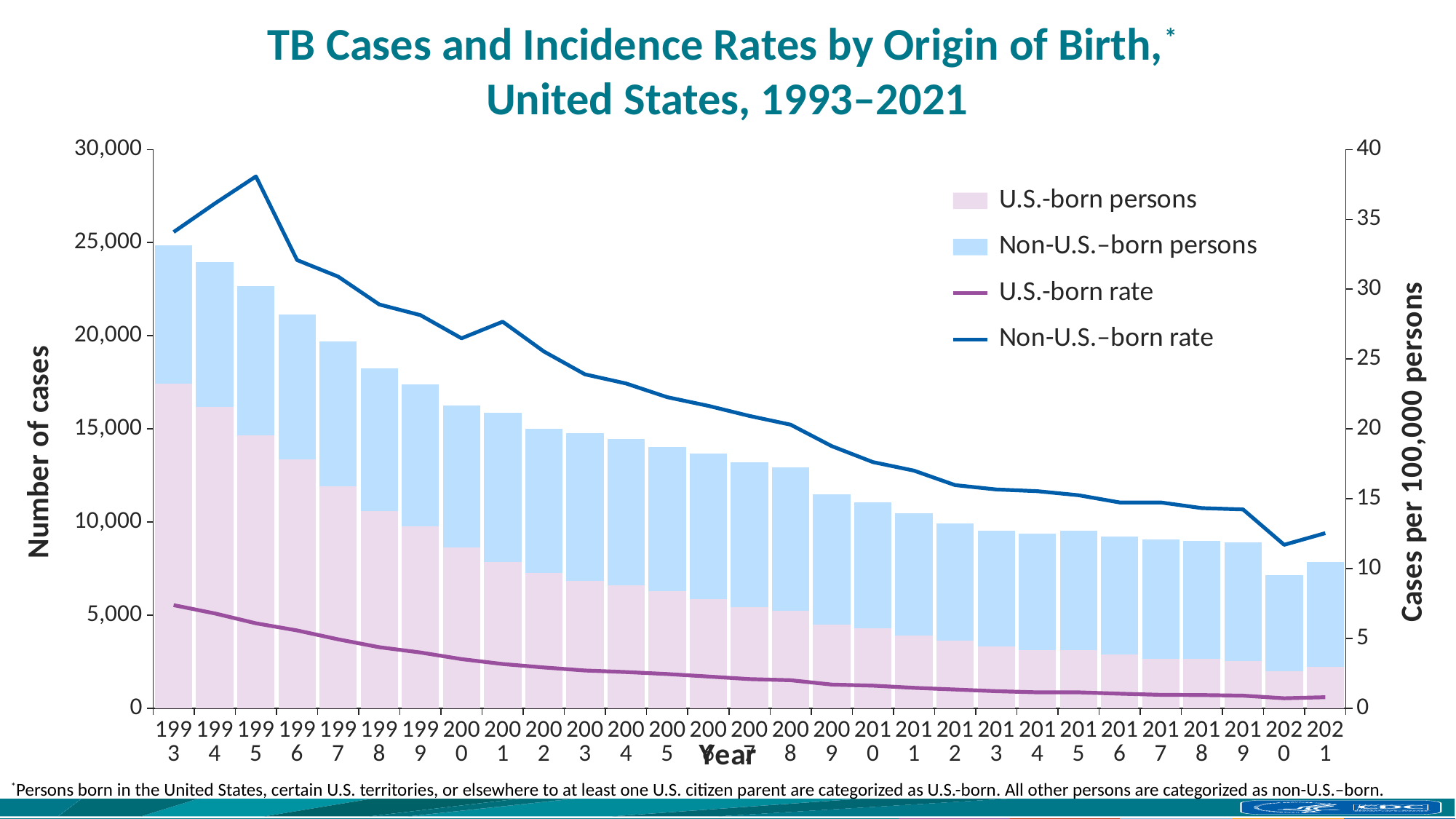
Does the Non-U.S.-born rate generally rise or fall from 1995 to 2021? fall In which year is the Non-U.S.-born rate highest? 1995 What is the label of the right-hand vertical axis? Cases per 100,000 persons In 1993, which group accounts for more TB cases: U.S.-born persons or Non-U.S.-born persons? U.S.-born persons How many series does the legend list? 4 What kind of chart is used to show the number of TB cases? Stacked bar chart (with line series for rates) In which year is the total number of TB cases lowest? 2020 Is the total number of TB cases in 2021 greater or less than 10,000? less How many years are shown along the x axis? 29 Is the Non-U.S.-born rate in 1995 greater or less than 35 cases per 100,000 persons? greater In which year is the total number of TB cases highest? 1993 Is the total number of TB cases in 1993 greater or less than 20,000? greater